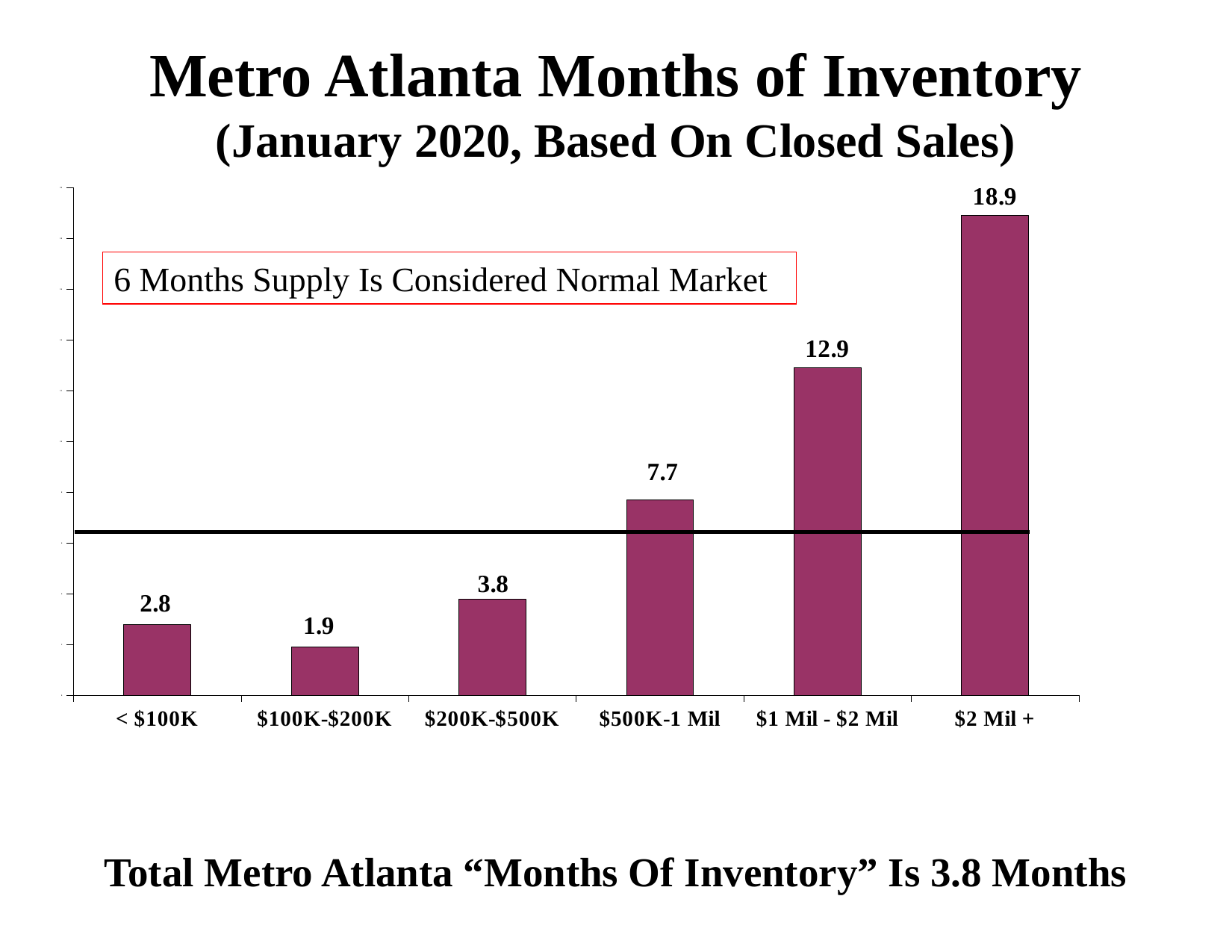
Which price range has the lowest months of inventory? $100K-$200K Which has a higher months of inventory value, < $100K or $200K-$500K? $200K-$500K According to the text box on the chart, how many months of supply is considered a normal market? 6 Months What is the months of inventory value for the $500K-1 Mil price range? 7.7 Do the months of inventory values generally rise or fall as the price range increases from $100K-$200K to $2 Mil +? Rise What is the difference in months of inventory between the $200K-$500K and $100K-$200K price ranges? 1.9 What is the months of inventory value for the < $100K price range? 2.8 How many price range categories are shown on the chart? 6 What kind of chart is shown on the slide? Bar chart What is the months of inventory value for the $1 Mil - $2 Mil price range? 12.9 What is the difference in months of inventory between the $2 Mil + and $1 Mil - $2 Mil price ranges? 6.0 Which price range has the highest months of inventory? $2 Mil +